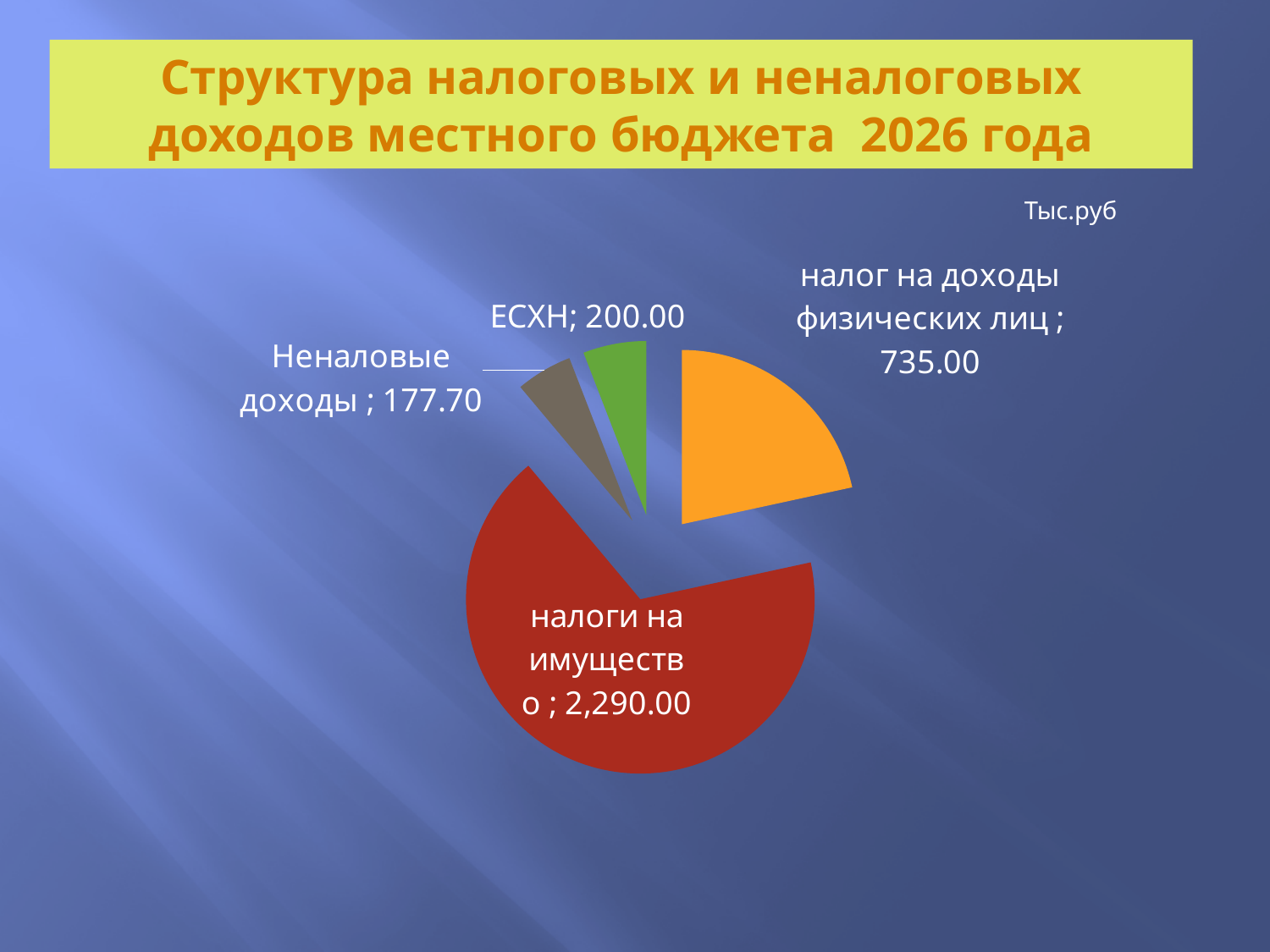
Which category has the largest slice of the pie? налоги на имущество What is the difference between ЕСХН and Неналовые доходы? 22.30 What unit is indicated for the values on the slide? Тыс.руб What is the difference between налоги на имущество and налог на доходы физических лиц? 1,555.00 What is the value for налоги на имущество? 2,290.00 What is the value for Неналовые доходы? 177.70 What is the value for налог на доходы физических лиц? 735.00 What is the value for ЕСХН? 200.00 Which is larger, ЕСХН or налог на доходы физических лиц? налог на доходы физических лиц How many categories are shown in the pie chart? 4 What kind of chart is shown on the slide? pie chart Which category has the smallest slice of the pie? Неналовые доходы